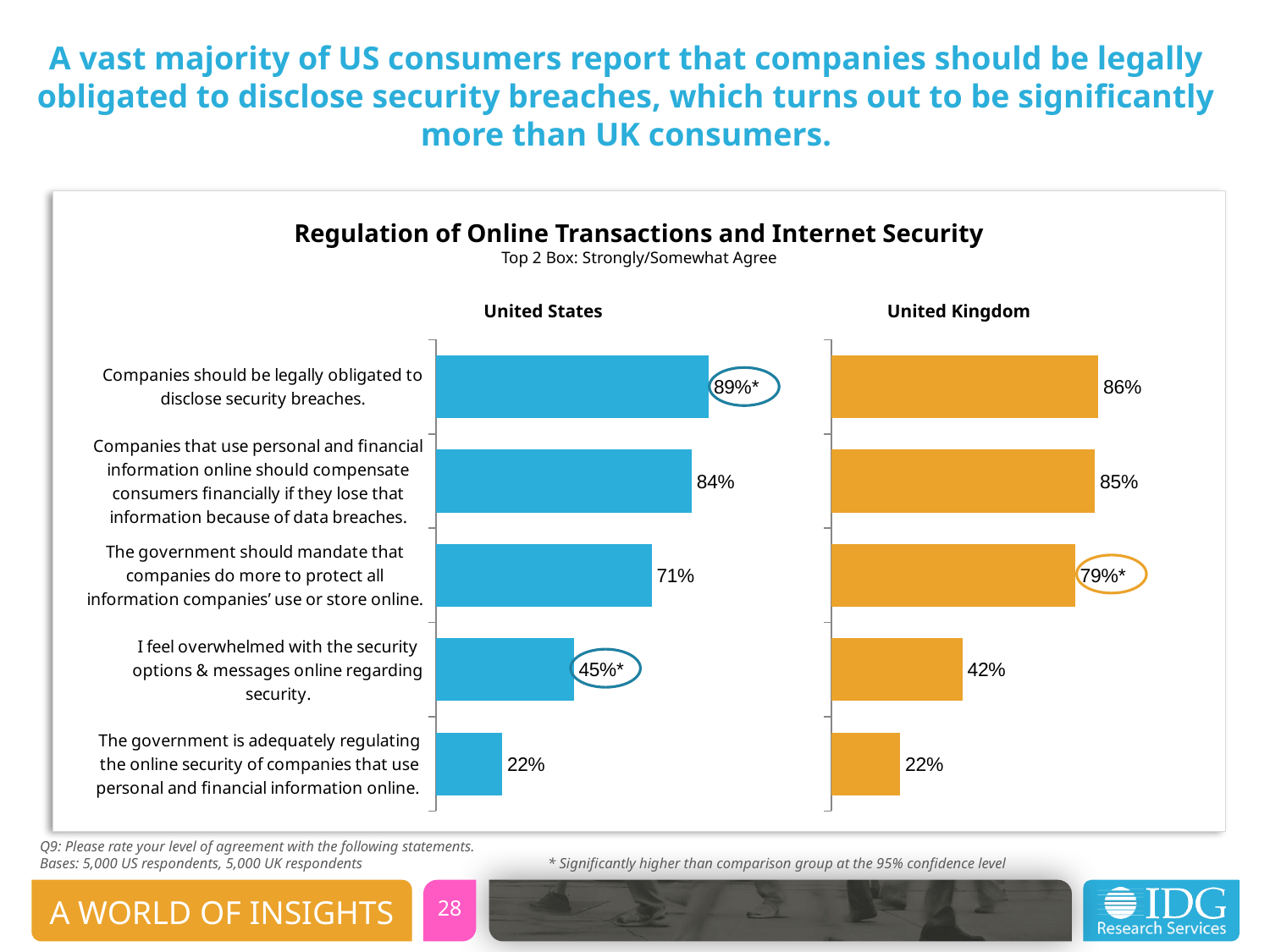
In the United States chart, what percentage feel overwhelmed with the security options & messages online regarding security? 45%* For the statement about feeling overwhelmed with security options & messages online, which is larger, the United States value or the United Kingdom value? United States In the United Kingdom chart, which statement has the highest level of agreement? Companies should be legally obligated to disclose security breaches. What is the difference between the US and UK percentages for the statement that the government should mandate that companies do more to protect information? 8 percentage points In the United States chart, which statement has the lowest level of agreement? The government is adequately regulating the online security of companies that use personal and financial information online. What colour are the bars in the United Kingdom chart? Orange How many statements are shown in each of the two charts? 5 In the United States chart, what percentage agree that companies should be legally obligated to disclose security breaches? 89%* In the United Kingdom chart, what percentage agree that the government should mandate that companies do more to protect all information companies use or store online? 79%* In the United Kingdom chart, what percentage agree that companies that use personal and financial information online should compensate consumers financially if they lose that information? 85% What is the title of the chart on the slide? Regulation of Online Transactions and Internet Security What type of chart is used to show the United States and United Kingdom results? Bar chart